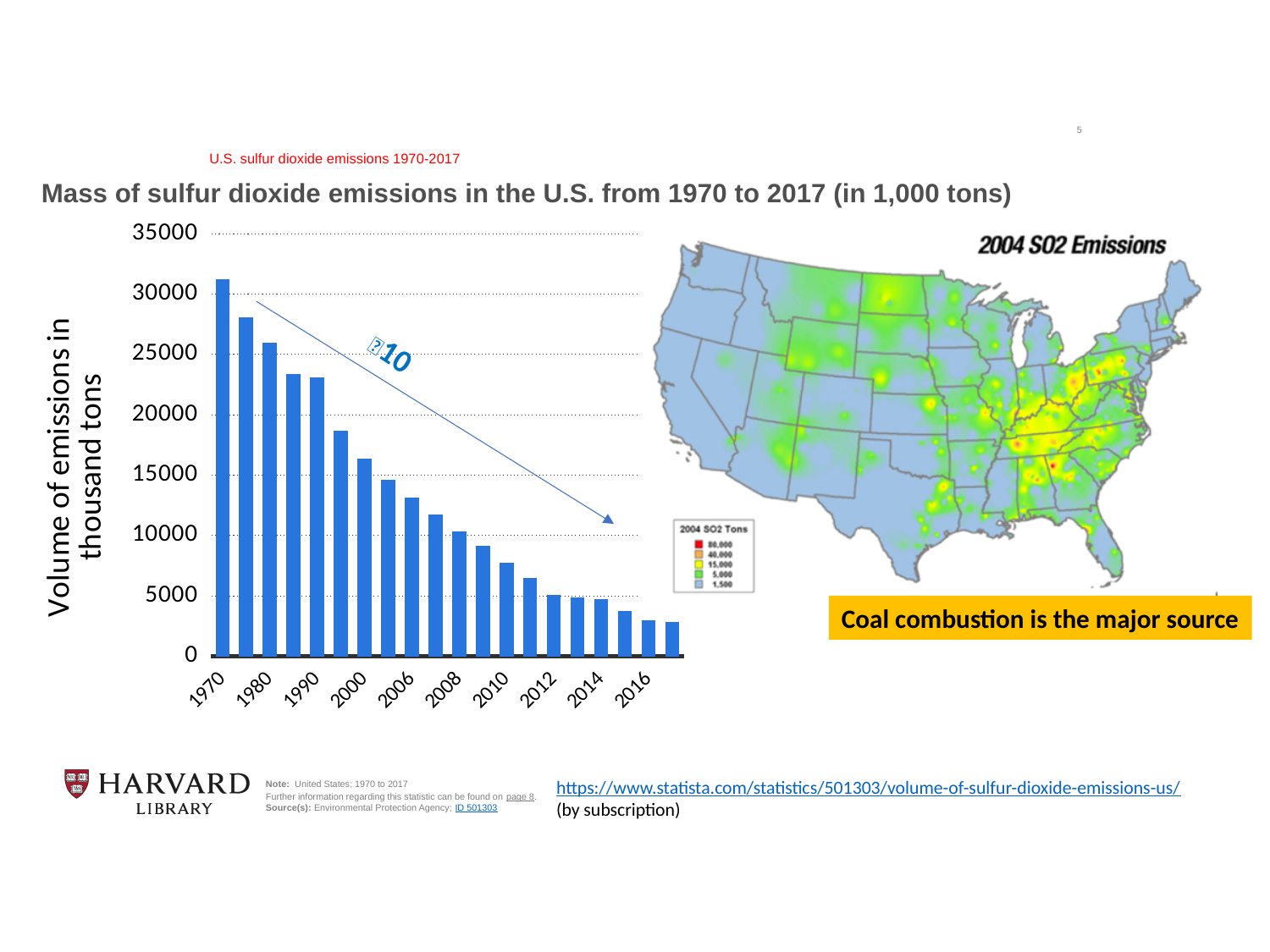
Is the value for 2000 greater or less than 20000? less What is the y-axis label of the bar chart? Volume of emissions in thousand tons Do sulfur dioxide emissions rise or fall from 1970 to 2017 in the bar chart? Fall Is the value for 2010 greater or less than 10000? less What type of chart shows the mass of sulfur dioxide emissions in the U.S. from 1970 to 2017? Bar chart How many year labels are shown on the x axis of the bar chart? 10 Which year has the highest sulfur dioxide emissions in the bar chart? 1970 Is the value for 1970 greater or less than 25000? greater Which year has higher sulfur dioxide emissions, 1970 or 2016? 1970